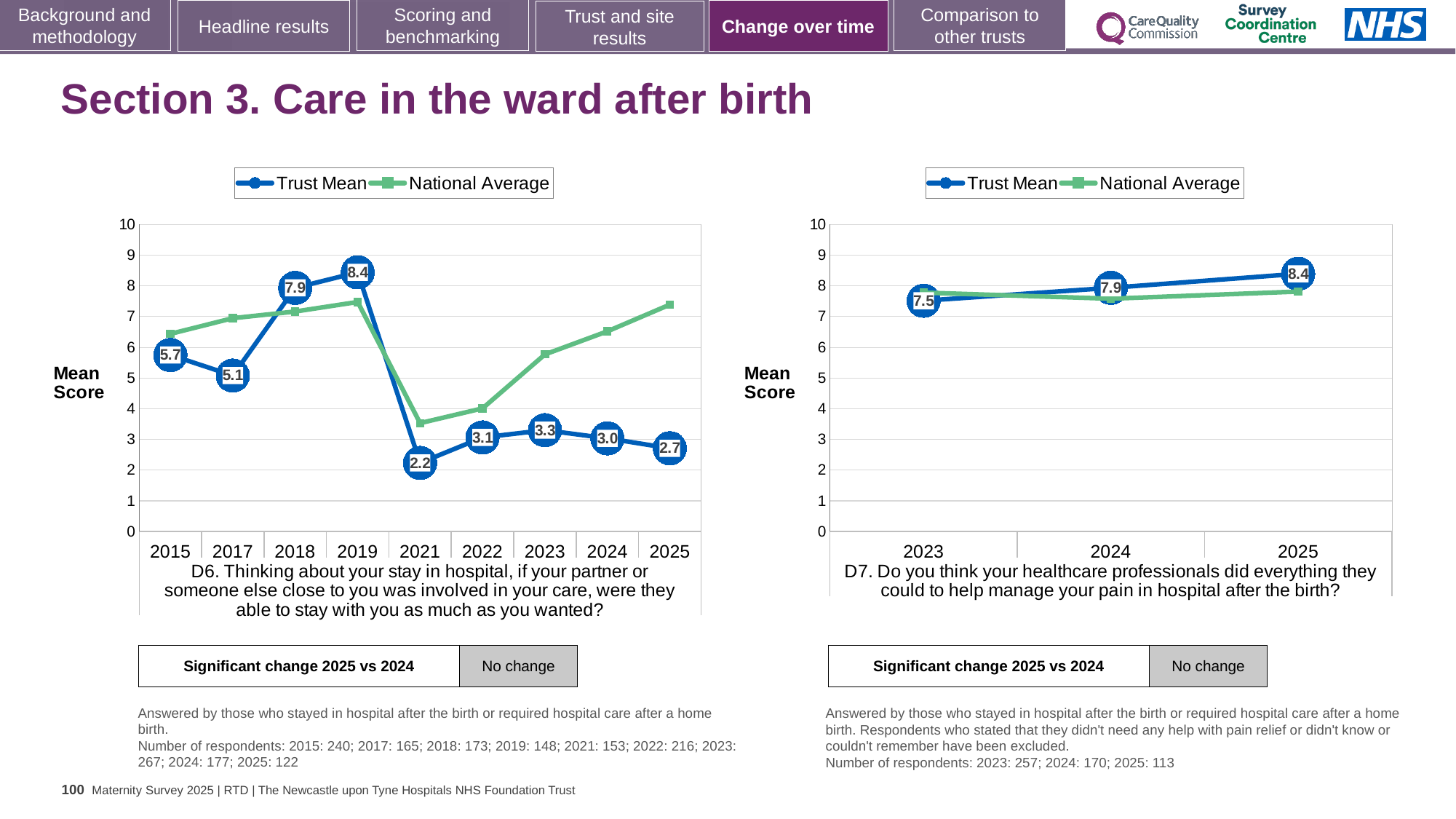
On the left chart (D6), what is the Trust Mean score for 2021? 2.2 On the right chart (D7), which is larger in 2025, the Trust Mean or the National Average? Trust Mean On the right chart (D7), what is the Trust Mean score for 2023? 7.5 On the left chart (D6), in which year is the Trust Mean lowest? 2021 On the right chart (D7), does the Trust Mean rise or fall from 2023 to 2025? rise On the left chart (D6), is the National Average for 2025 greater or less than 7? greater On the left chart (D6), how many years are shown on the x axis? 9 What type of chart is the left chart (D6)? line chart On the left chart (D6), what is the Trust Mean score for 2019? 8.4 On the left chart (D6), in which year is the Trust Mean highest? 2019 On the right chart (D7), how many series does the legend list? 2 On the left chart (D6), what is the difference between the Trust Mean in 2019 and in 2021? 6.2